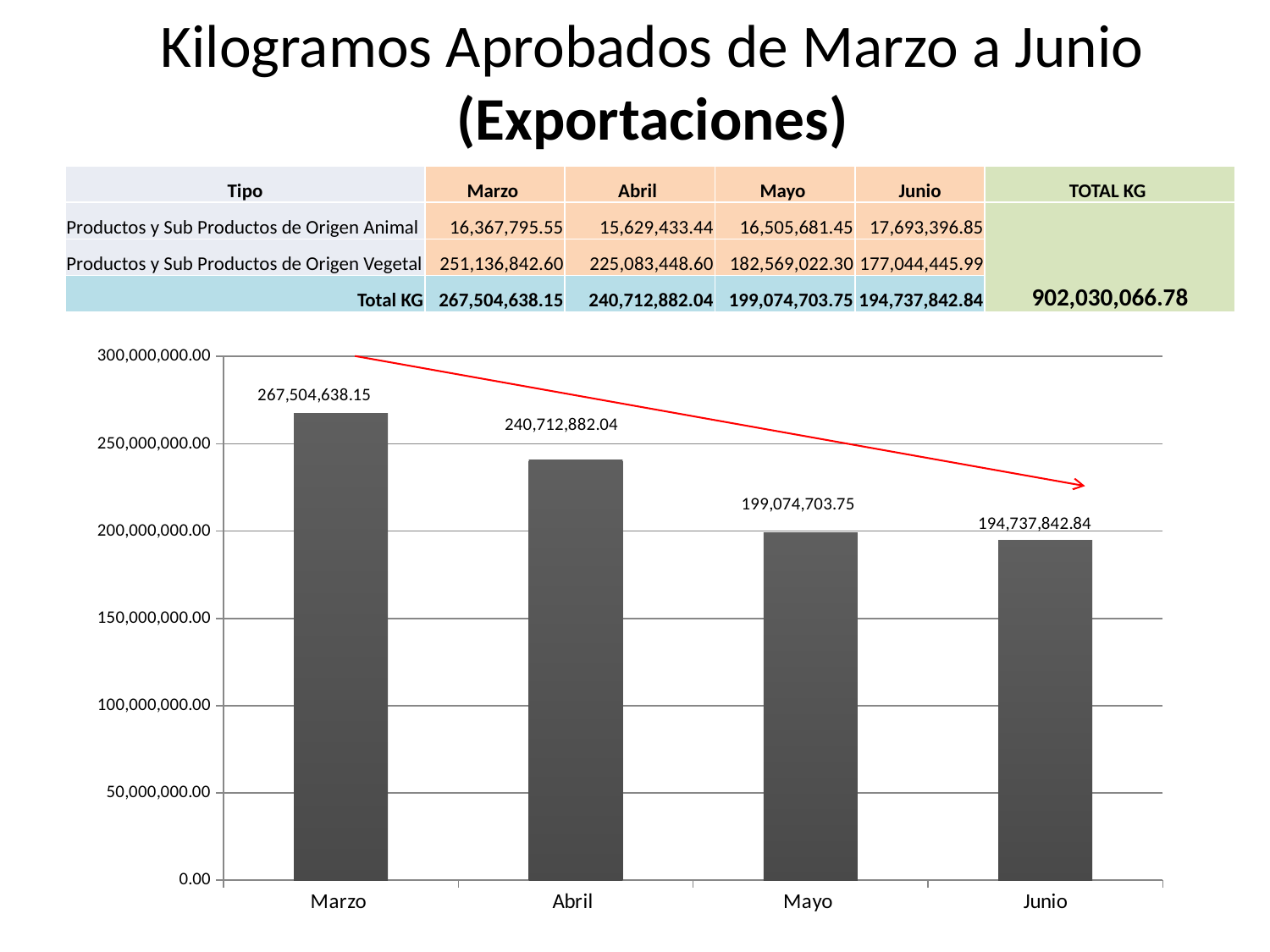
What is the value of the bar for Junio? 194,737,842.84 Which month has the highest bar? Marzo What is the difference between the values for Marzo and Junio? 72,766,795.31 Which is larger, the value for Abril or the value for Mayo? Abril What is the value of the bar for Marzo? 267,504,638.15 Is the value for Junio greater or less than 200,000,000.00? less Do the values rise or fall from Marzo to Junio? fall What is the value of the bar for Mayo? 199,074,703.75 Which month has the lowest bar? Junio What kind of chart is shown on the slide? bar chart How many bars are shown in the chart? 4 What is the difference between the values for Marzo and Abril? 26,791,756.11